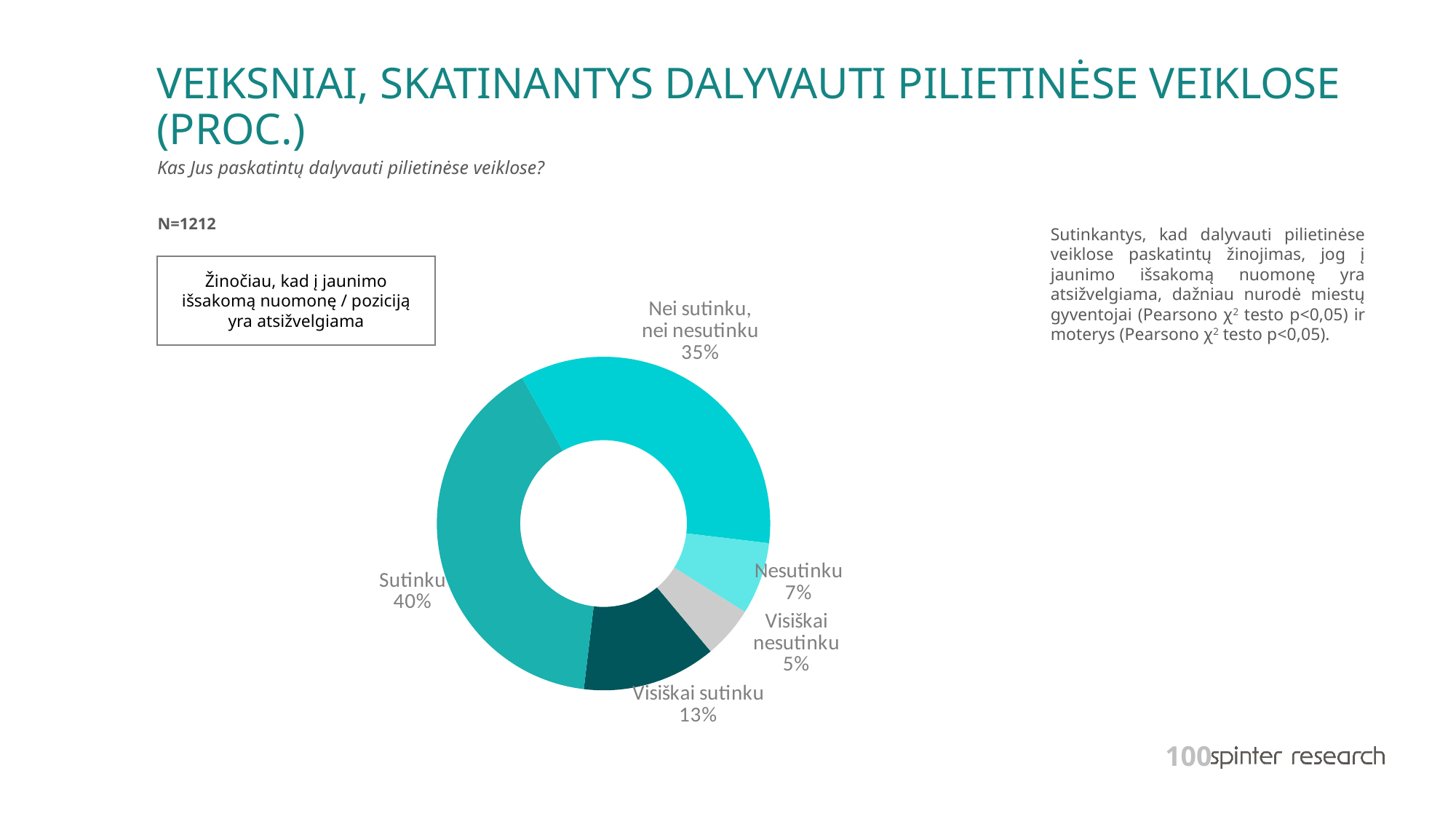
Which is larger: the share for "Visiškai sutinku" or the share for "Nesutinku"? Visiškai sutinku What percentage of respondents answered "Nesutinku"? 7% What percentage of respondents answered "Visiškai sutinku"? 13% What kind of chart is shown on the slide? Doughnut (pie) chart How many response categories are shown in the chart? 5 Which response category has the largest share? Sutinku What is the sample size (N) stated on the slide? N=1212 Which response category has the smallest share? Visiškai nesutinku What is the difference in percentage points between "Sutinku" and "Nei sutinku, nei nesutinku"? 5 percentage points What percentage of respondents answered "Visiškai nesutinku"? 5% What percentage of respondents answered "Nei sutinku, nei nesutinku"? 35% What percentage of respondents answered "Sutinku"? 40%